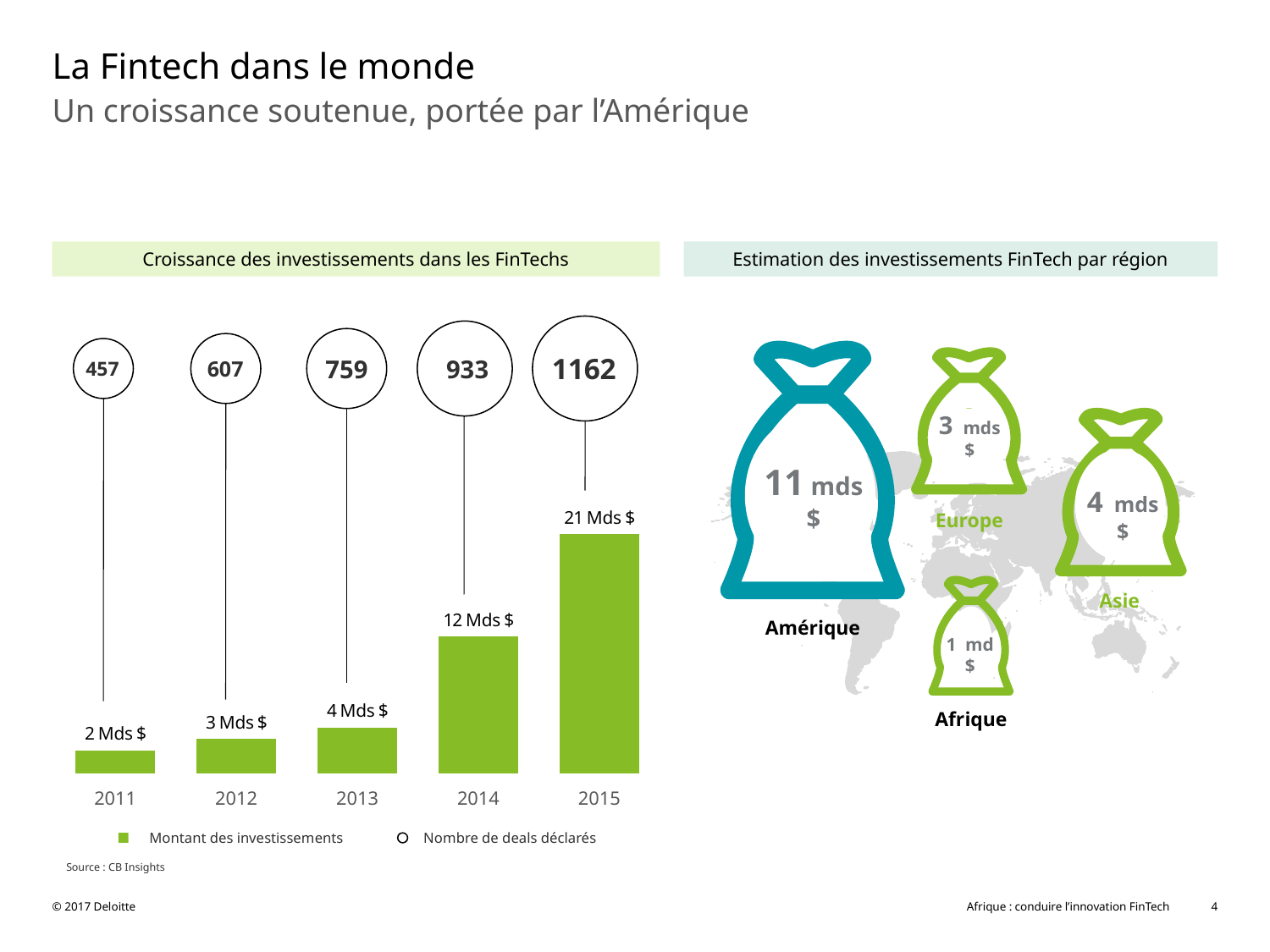
In the graphic 'Estimation des investissements FinTech par région', what is the estimated investment for Amérique? 11 mds $ In the chart 'Croissance des investissements dans les FinTechs', what is the difference in investment amount between 2015 and 2014? 9 Mds $ In the chart 'Croissance des investissements dans les FinTechs', how many deals were declared in 2013? 759 In the chart 'Croissance des investissements dans les FinTechs', which year has the highest investment amount? 2015 In the chart 'Croissance des investissements dans les FinTechs', how many series does the legend list? 2 In the chart 'Croissance des investissements dans les FinTechs', how many deals were declared in 2015? 1162 In the chart 'Croissance des investissements dans les FinTechs', what is the difference in the number of declared deals between 2012 and 2011? 150 In the chart 'Croissance des investissements dans les FinTechs', do the investment amounts rise or fall from 2011 to 2015? rise In the chart 'Croissance des investissements dans les FinTechs', which year has the lowest number of declared deals? 2011 In the chart 'Croissance des investissements dans les FinTechs', what is the investment amount for 2015? 21 Mds $ In the chart 'Croissance des investissements dans les FinTechs', what is the investment amount for 2011? 2 Mds $ In the chart 'Croissance des investissements dans les FinTechs', how many years are shown on the x axis? 5